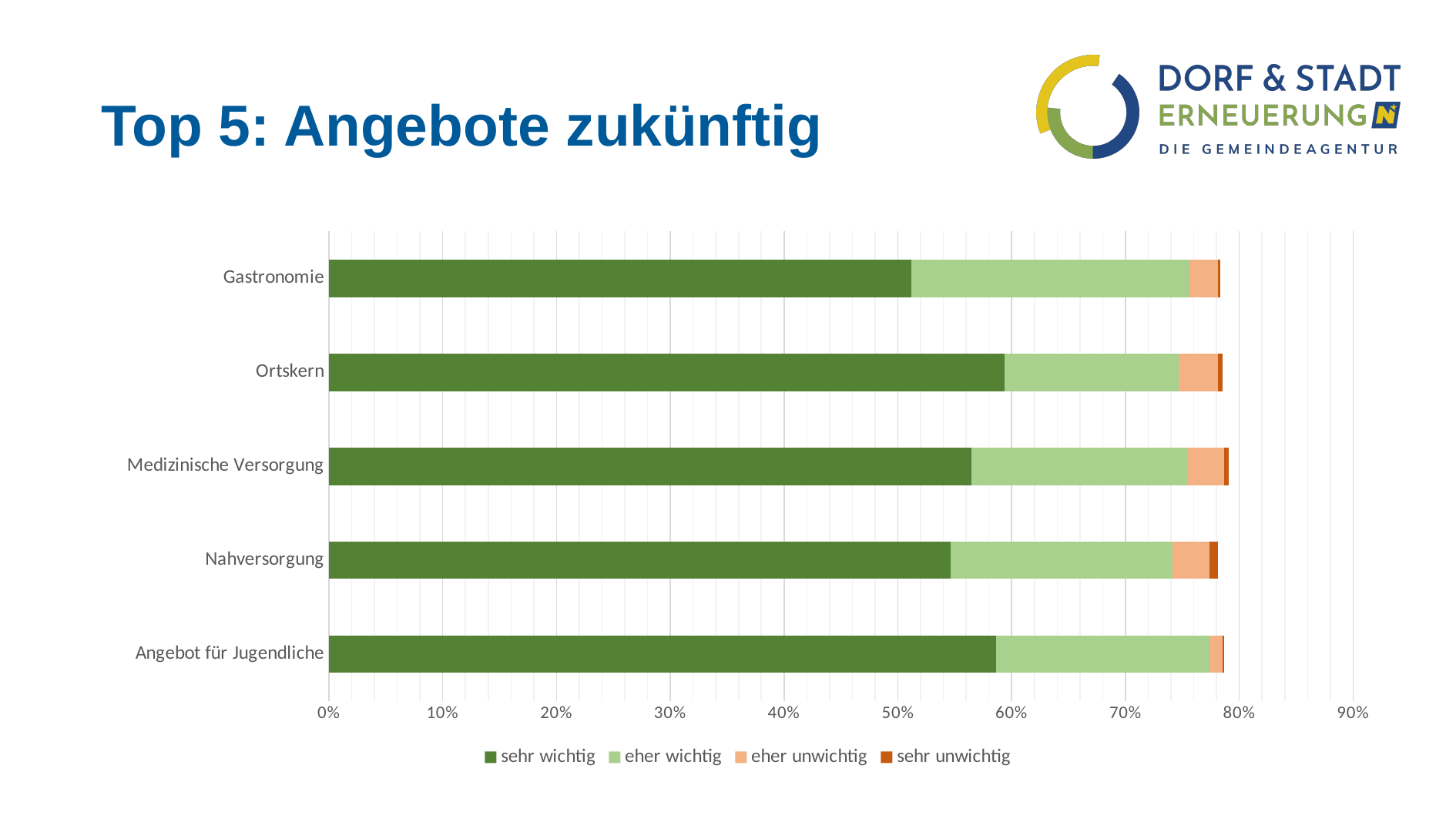
How many series does the legend list? 4 Which legend entry is shown in dark green? sehr wichtig Which category has the lowest value for "sehr wichtig"? Gastronomie Is the "sehr wichtig" value for Nahversorgung greater or less than 60%? less Which has the larger "sehr wichtig" value, Gastronomie or Ortskern? Ortskern How many categories are shown on the chart? 5 What is the title of the slide? Top 5: Angebote zukünftig What kind of chart is shown on the slide? bar chart Which has the larger "sehr wichtig" value, Nahversorgung or Angebot für Jugendliche? Angebot für Jugendliche Is the "sehr wichtig" value for Ortskern greater or less than 50%? greater Is the "sehr wichtig" value for Gastronomie greater or less than 60%? less